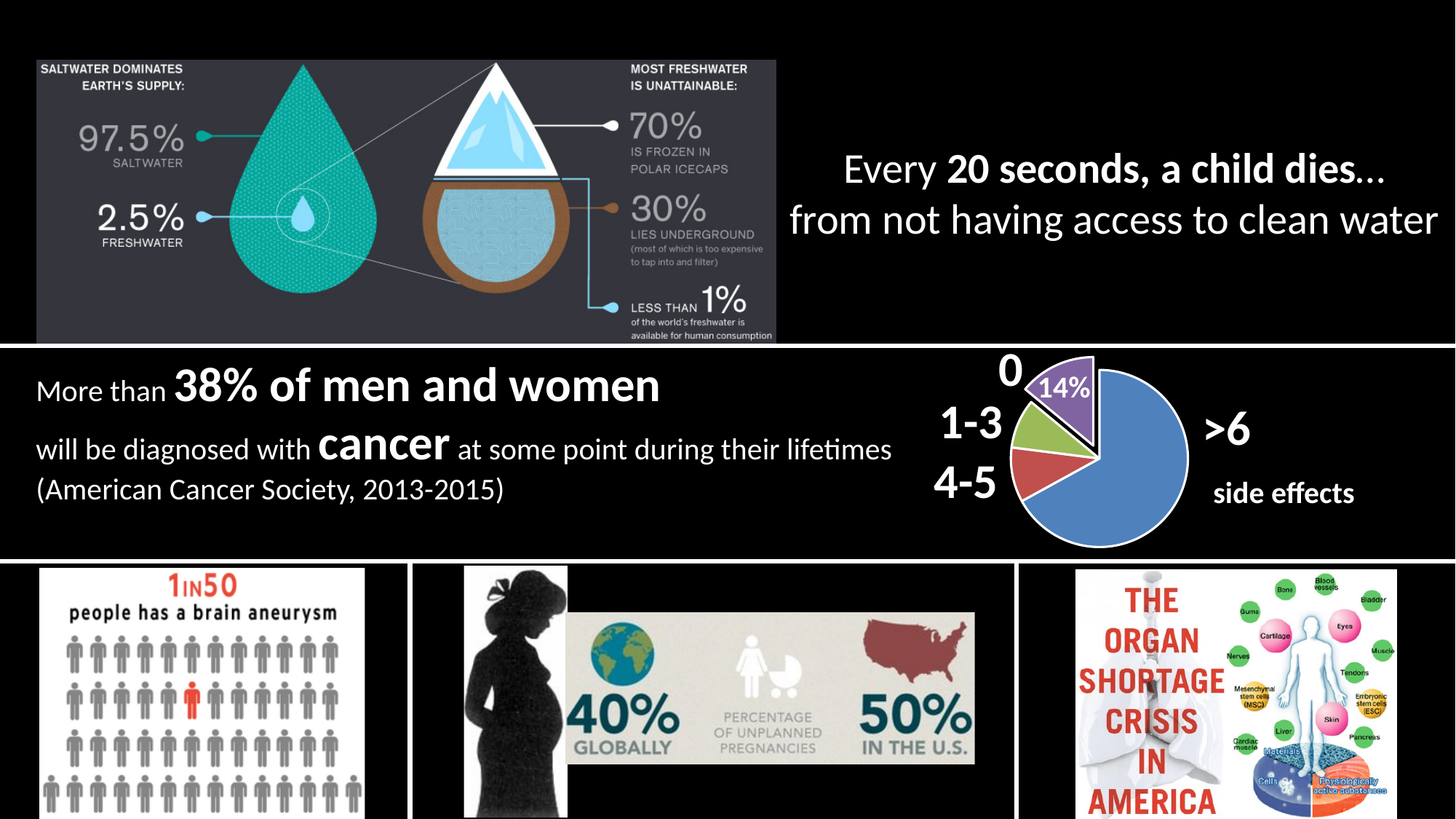
Which category has the largest slice in the side effects pie chart? >6 What do the slices of the pie chart in the middle band represent? side effects In the side effects pie chart, which slice is larger: >6 or 0? >6 In the side effects pie chart, is the share for >6 greater or less than 50%? greater In the water infographic at the top left, what percentage of freshwater lies underground? 30% How many categories does the side effects pie chart show? 4 What kind of chart is the side effects chart on the right of the middle band? pie chart In the water infographic at the top left, what percentage of freshwater is frozen in polar icecaps? 70% In the side effects pie chart, is the share for 1-3 greater or less than 25%? less In the side effects pie chart, what share is shown for the category 0? 14% In the water infographic at the top left, what percentage of Earth's water supply is saltwater? 97.5% What colour is the >6 slice in the side effects pie chart? blue